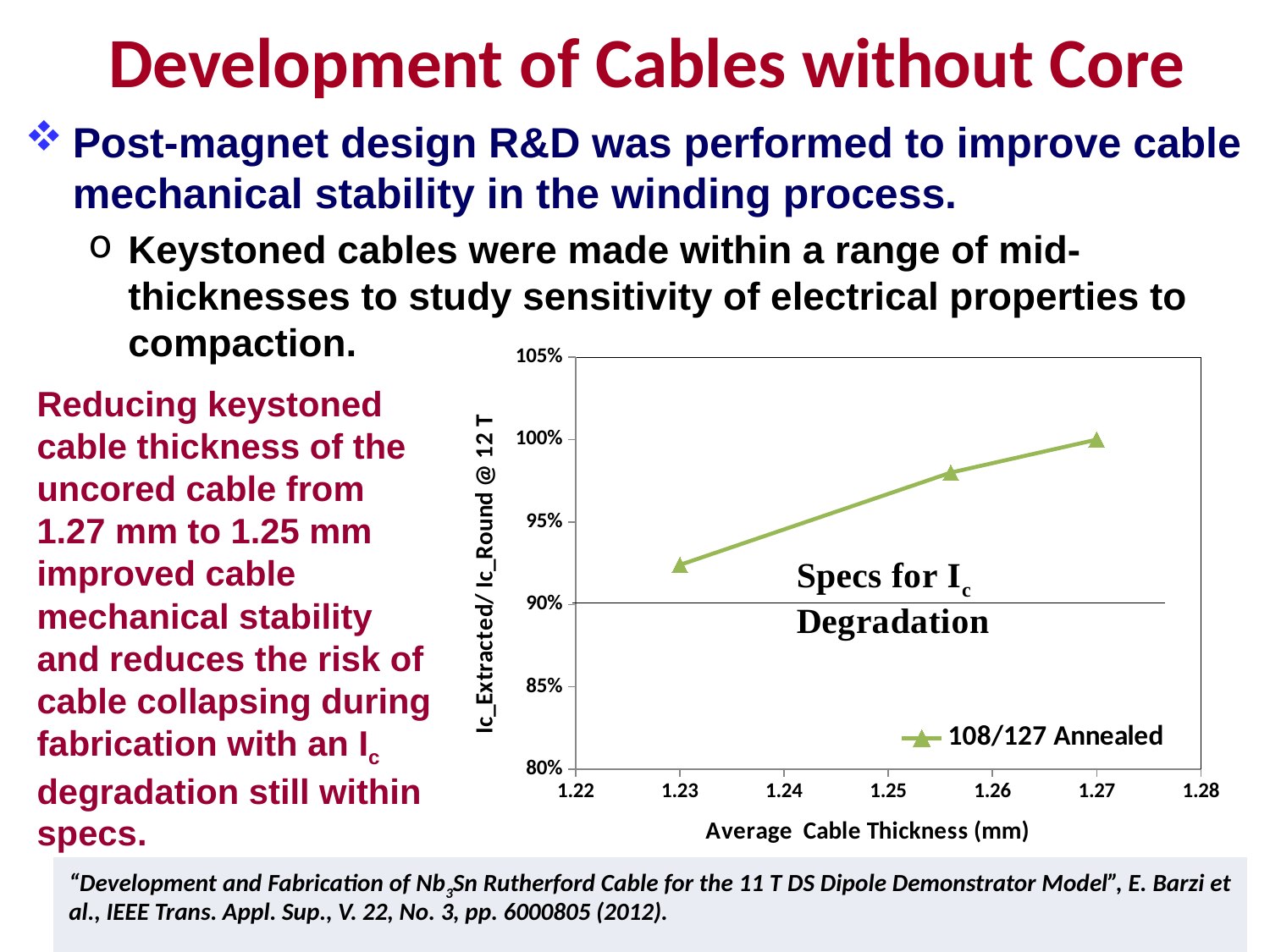
How many series does the chart legend list? 1 Which has the larger Ic_Extracted/Ic_Round ratio: the point at 1.23 mm or the point at 1.27 mm? 1.27 mm Is the value for the data point at 1.27 mm greater or less than 95%? greater At which average cable thickness is the Ic_Extracted/Ic_Round ratio highest? 1.27 How many data points are plotted on the 108/127 Annealed line? 3 What is the name of the series shown in the chart legend? 108/127 Annealed What is the title of the x axis of the chart? Average Cable Thickness (mm) Does the Ic_Extracted/Ic_Round ratio rise or fall as average cable thickness increases along the x axis? rise Is the value for the data point at 1.23 mm greater or less than 95%? less What kind of chart is shown on the slide? line chart Is the value for the data point at 1.23 mm greater or less than 90%? greater At which average cable thickness is the Ic_Extracted/Ic_Round ratio lowest? 1.23